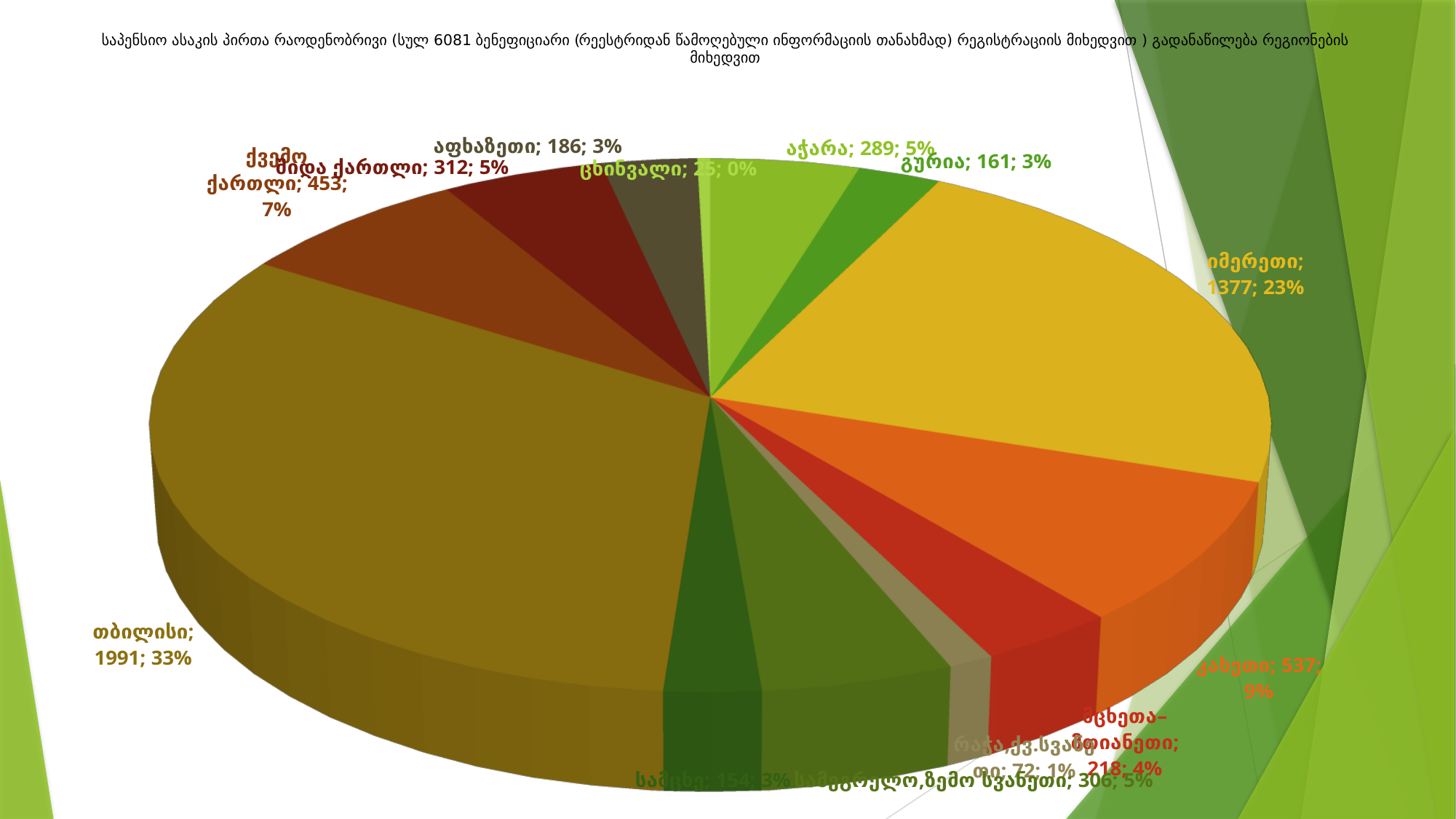
What value is shown for აჭარა? 289 What is the difference between the values for თბილისი and იმერეთი? 614 Which region has the largest slice of the pie? თბილისი Which is larger, the value for შიდა ქართლი or the value for აფხაზეთი? შიდა ქართლი What share of the pie does იმერეთი represent? 23% What value is shown for იმერეთი? 1377 What share of the pie does ქვემო ქართლი represent? 7% What kind of chart is shown on the slide? pie chart Which region has the smallest slice of the pie? ცხინვალი What value is shown for კახეთი? 537 How many regions (slices) are shown in the pie chart? 13 What value is shown for თბილისი? 1991